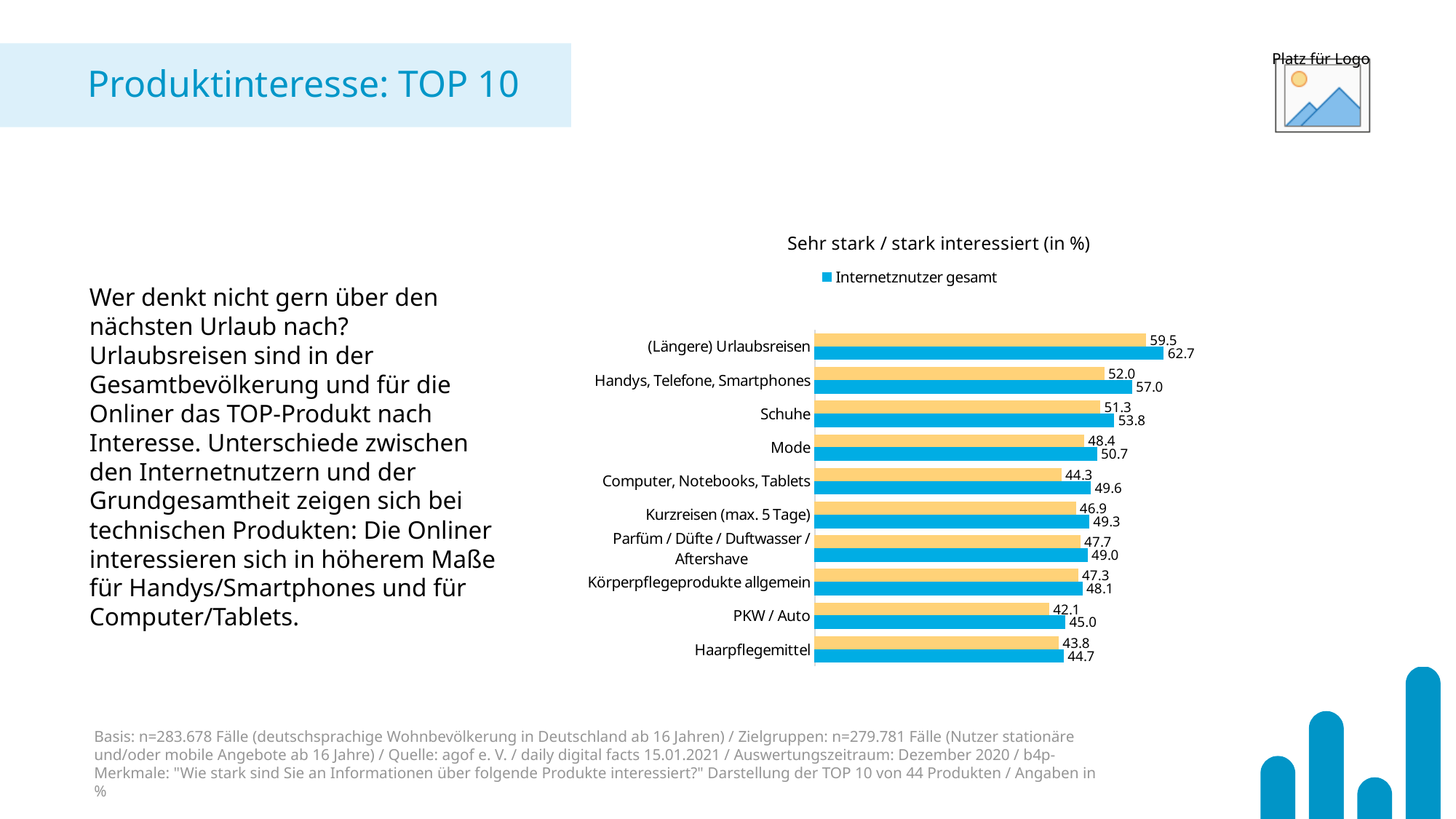
For Handys, Telefone, Smartphones, what is the difference between the Internetnutzer gesamt value and the yellow bar value? 5.0 What is the Internetnutzer gesamt value for Schuhe? 53.8 How many series does the chart legend list? 1 Which category has the highest Internetnutzer gesamt value? (Längere) Urlaubsreisen How many product categories are shown in the chart? 10 Which category has the lowest Internetnutzer gesamt value? Haarpflegemittel What is the title of the chart? Sehr stark / stark interessiert (in %) What value does the yellow bar show for Computer, Notebooks, Tablets? 44.3 For (Längere) Urlaubsreisen, how much higher is the Internetnutzer gesamt value than the yellow bar value? 3.2 What type of chart is shown on the slide? Bar chart Which has the larger Internetnutzer gesamt value, Mode or Kurzreisen (max. 5 Tage)? Mode What is the Internetnutzer gesamt value for PKW / Auto? 45.0